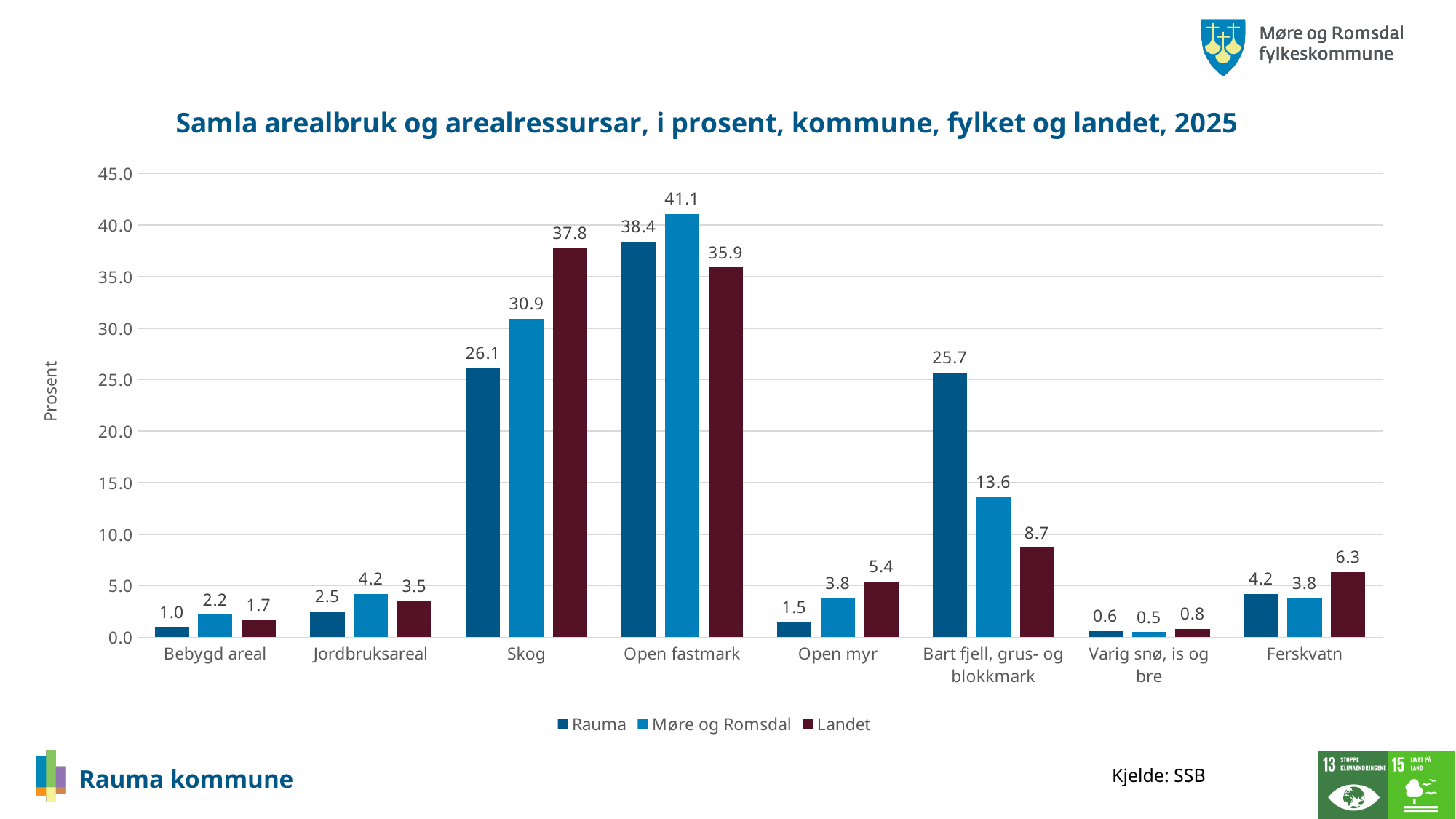
Which category has the highest value for Rauma? Open fastmark What is the value for Landet in the Bart fjell, grus- og blokkmark category? 8.7 What kind of chart is shown on the slide? Bar chart Which category has the lowest value for Landet? Varig snø, is og bre What is the difference between the Landet and Rauma values for Skog? 11.7 How many categories are shown on the x axis? 8 Which is larger in the Ferskvatn category: Rauma or Møre og Romsdal? Rauma What is the label of the y axis? Prosent What is the value for Møre og Romsdal in the Open fastmark category? 41.1 What is the value for Rauma in the Skog category? 26.1 Is the value for Møre og Romsdal in the Bart fjell, grus- og blokkmark category greater or less than 15.0? less How many series does the legend list? 3